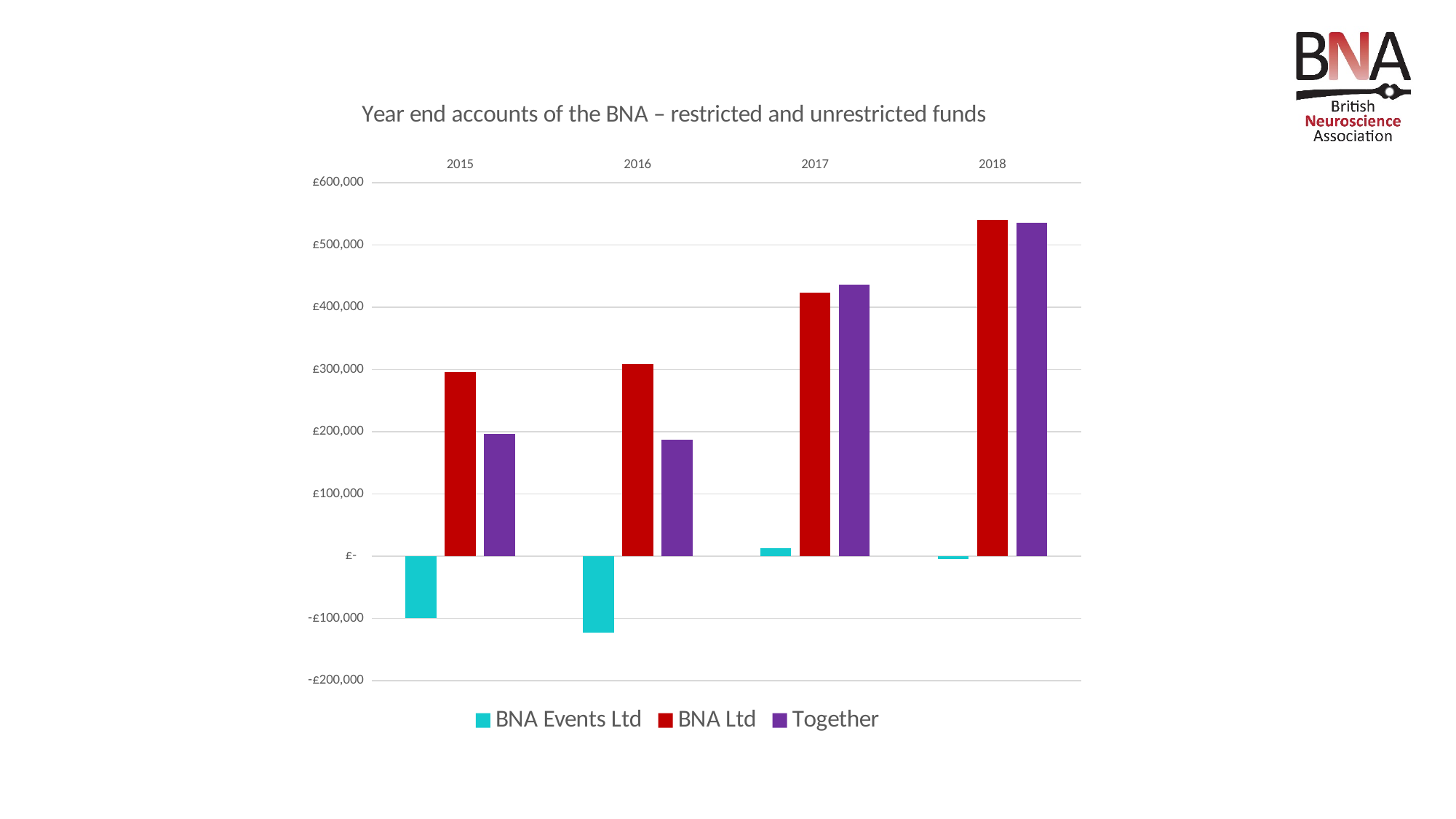
In which year is the BNA Ltd value highest? 2018 Which is larger in 2017, the value for BNA Events Ltd or the value for BNA Ltd? BNA Ltd Do the BNA Ltd values rise or fall from 2015 to 2018? rise Is the value for Together in 2015 greater or less than £300,000? less Which is larger in 2015, the value for BNA Ltd or the value for Together? BNA Ltd How many years are shown along the x axis? 4 How many series does the legend list? 3 In which year is the BNA Events Ltd value lowest? 2016 Is the value for BNA Ltd in 2018 greater or less than £500,000? greater What kind of chart is shown on the slide? bar chart What is the title of the chart? Year end accounts of the BNA – restricted and unrestricted funds Is the value for BNA Events Ltd in 2016 greater or less than -£100,000? less